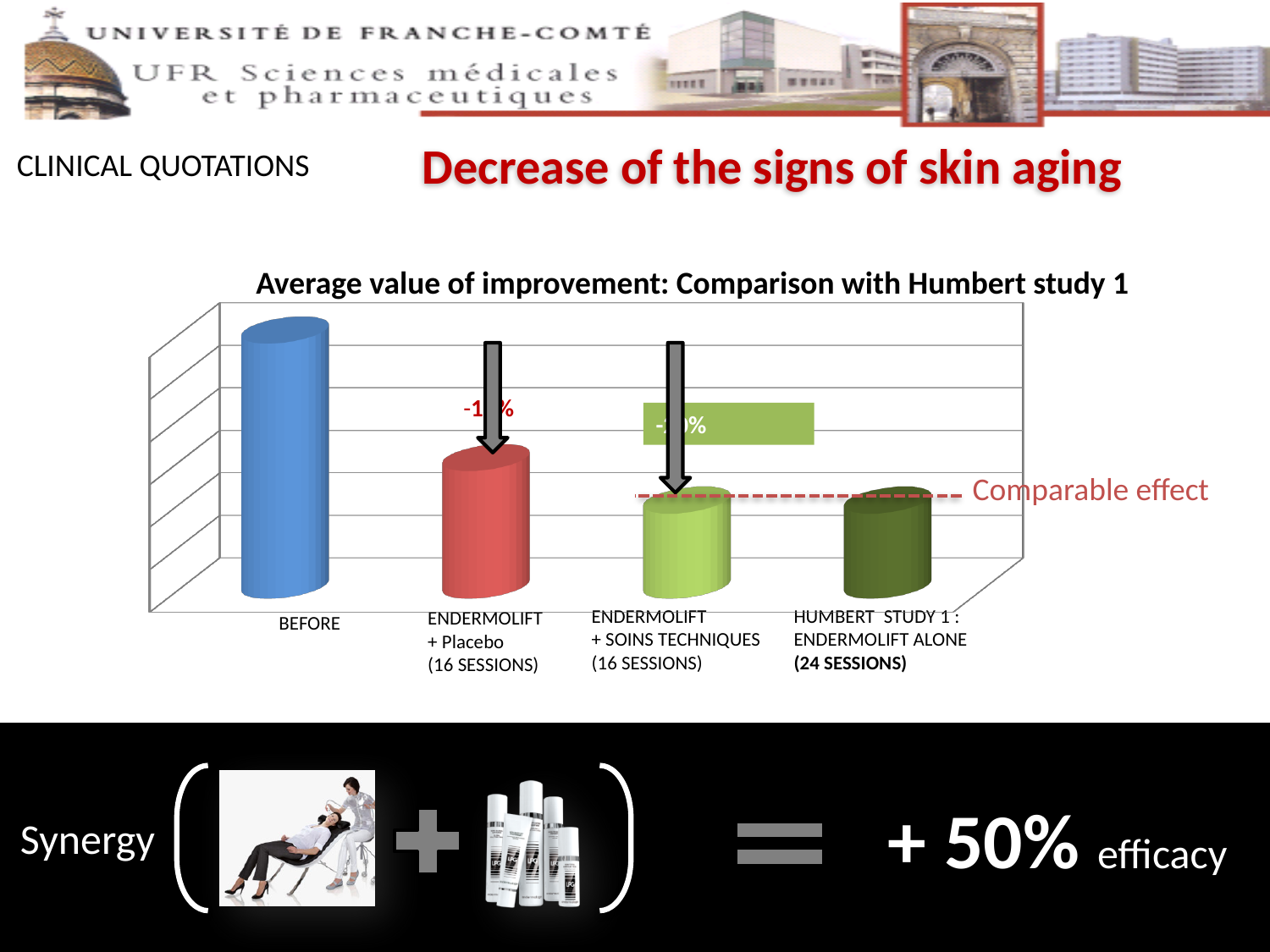
What is the title of the chart? Average value of improvement: Comparison with Humbert study 1 Which bar is taller: BEFORE or ENDERMOLIFT + Placebo (16 SESSIONS)? BEFORE Which bar is taller: ENDERMOLIFT + Placebo (16 SESSIONS) or ENDERMOLIFT + SOINS TECHNIQUES (16 SESSIONS)? ENDERMOLIFT + Placebo (16 SESSIONS) How many categories are plotted in the chart? 4 What kind of chart is shown on the slide? bar chart Do the bar values rise or fall from BEFORE to ENDERMOLIFT + SOINS TECHNIQUES (16 SESSIONS)? fall What colour is the BEFORE bar in the chart? blue Which category has the highest bar in the chart? BEFORE